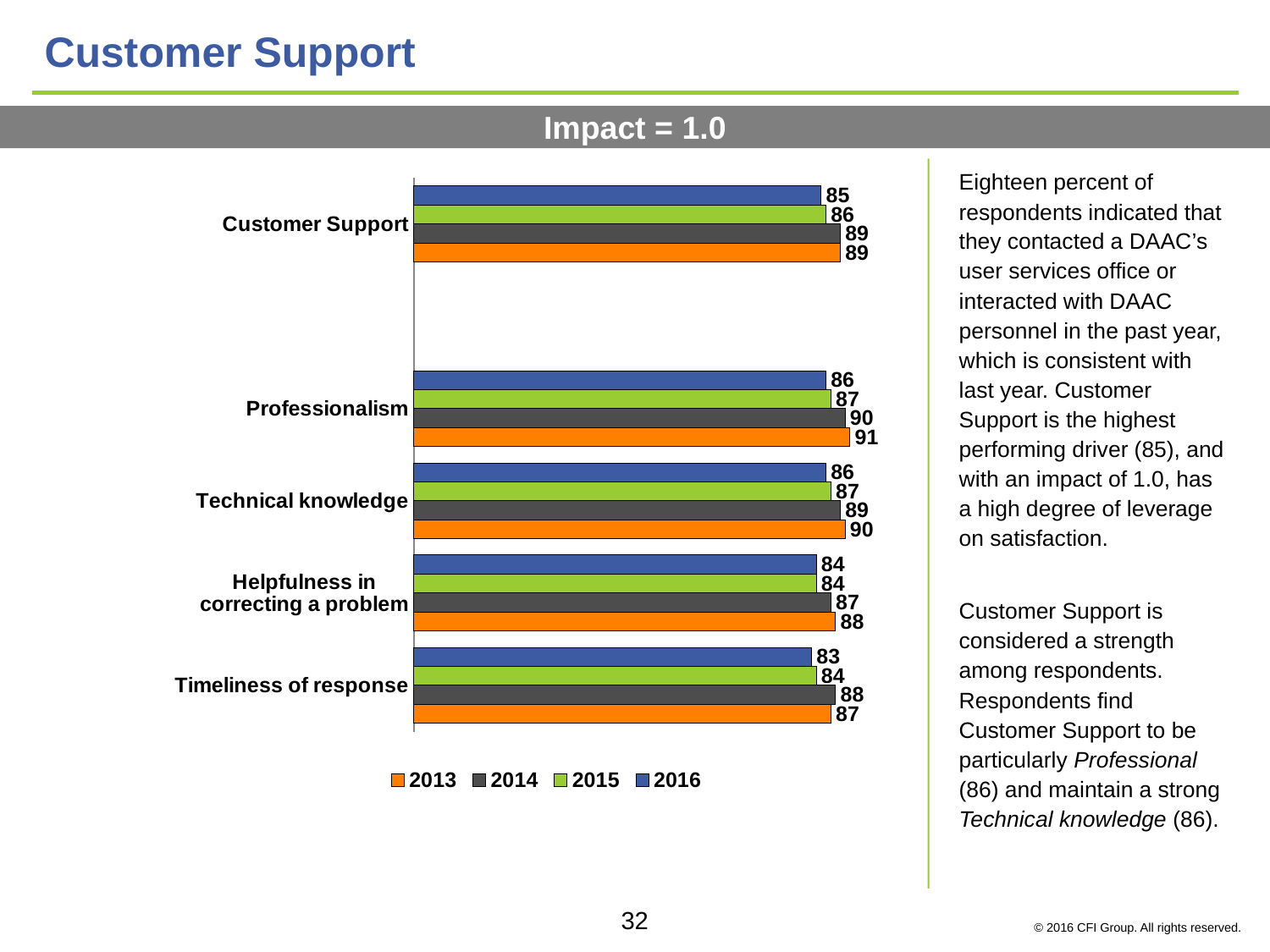
What is the 2013 value for Professionalism? 91 What is the difference between the 2013 and 2016 values for Professionalism? 5 What kind of chart is shown on the slide? Bar chart How many categories are shown on the chart? 5 Which colour represents the 2015 series in the legend? Green Which is larger for Timeliness of response, the 2014 value or the 2013 value? 2014 What is the 2014 value for Timeliness of response? 88 Which category has the lowest 2016 value? Timeliness of response How many series does the legend list? 4 What is the 2015 value for Helpfulness in correcting a problem? 84 Which category has the highest 2013 value? Professionalism What is the 2016 value for Customer Support? 85